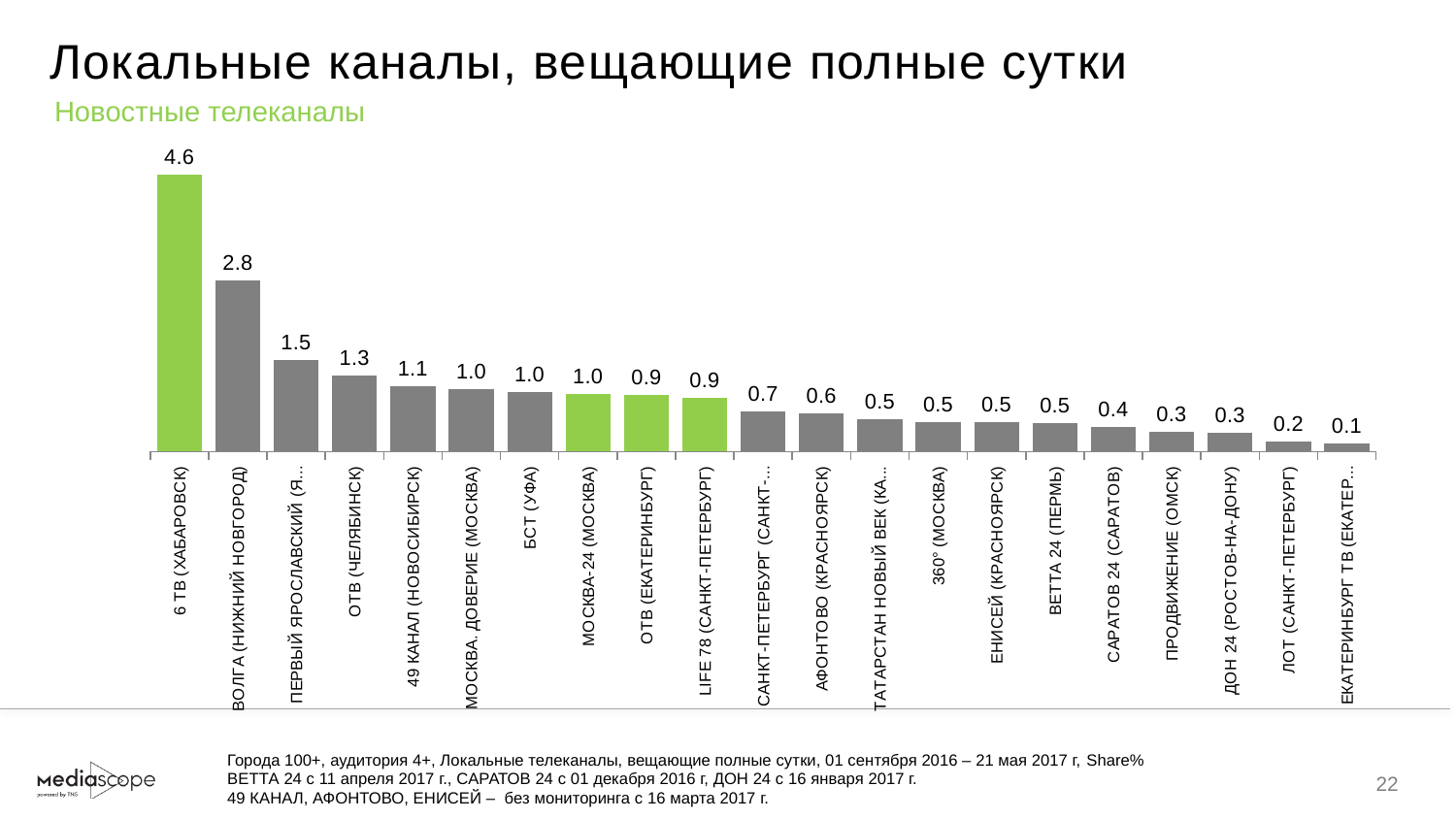
What is the value for ЛОТ (САНКТ-ПЕТЕРБУРГ)? 0.2 What is the value for ВОЛГА (НИЖНИЙ НОВГОРОД)? 2.8 What is the value for ОТВ (ЧЕЛЯБИНСК)? 1.3 How many channels are shown in the chart? 21 What is the value for АФОНТОВО (КРАСНОЯРСК)? 0.6 What is the difference between the values for 6 ТВ (ХАБАРОВСК) and ВОЛГА (НИЖНИЙ НОВГОРОД)? 1.8 Do the values rise or fall from left to right along the x axis? Fall What is the value for 6 ТВ (ХАБАРОВСК)? 4.6 Which channel has the lowest value? ЕКАТЕРИНБУРГ ТВ (ЕКАТЕР...) Which channel has the highest value? 6 ТВ (ХАБАРОВСК) Which is larger, the value for БСТ (УФА) or the value for САРАТОВ 24 (САРАТОВ)? БСТ (УФА) What kind of chart is shown on the slide? Bar chart